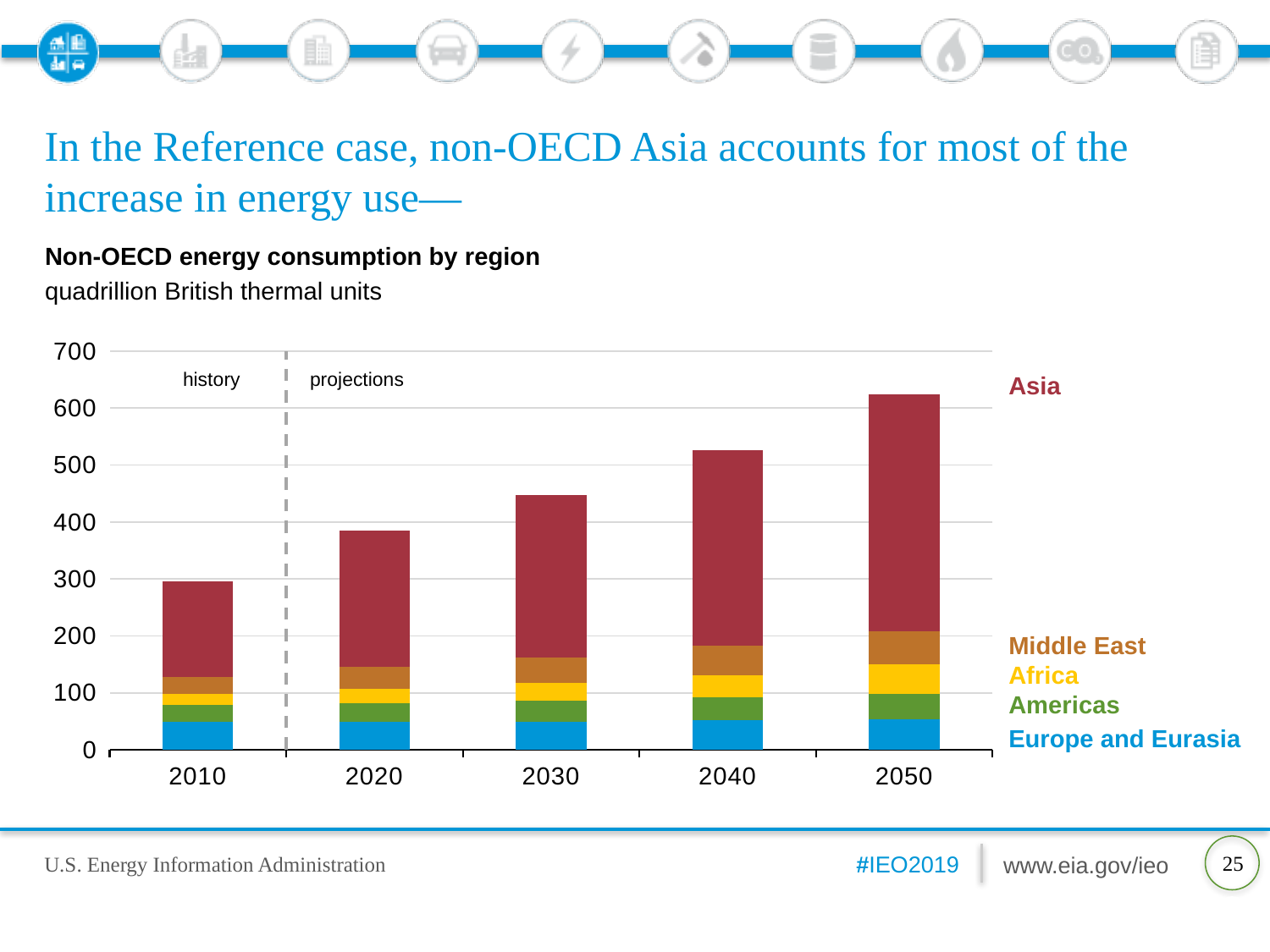
Is the total value for 2040 greater or less than 500? greater What kind of chart is shown on the slide? stacked bar chart How many years (bars) are shown on the x axis? 5 Which region accounts for the largest segment of each bar? Asia Do total non-OECD energy consumption values rise or fall from 2010 to 2050? rise Is the total value for 2030 greater or less than 400? greater Which year has the highest total non-OECD energy consumption? 2050 Is the total value for 2050 greater or less than 600? greater What is the title of the chart? Non-OECD energy consumption by region How many regions does the legend list? 5 Which year has the lowest total non-OECD energy consumption? 2010